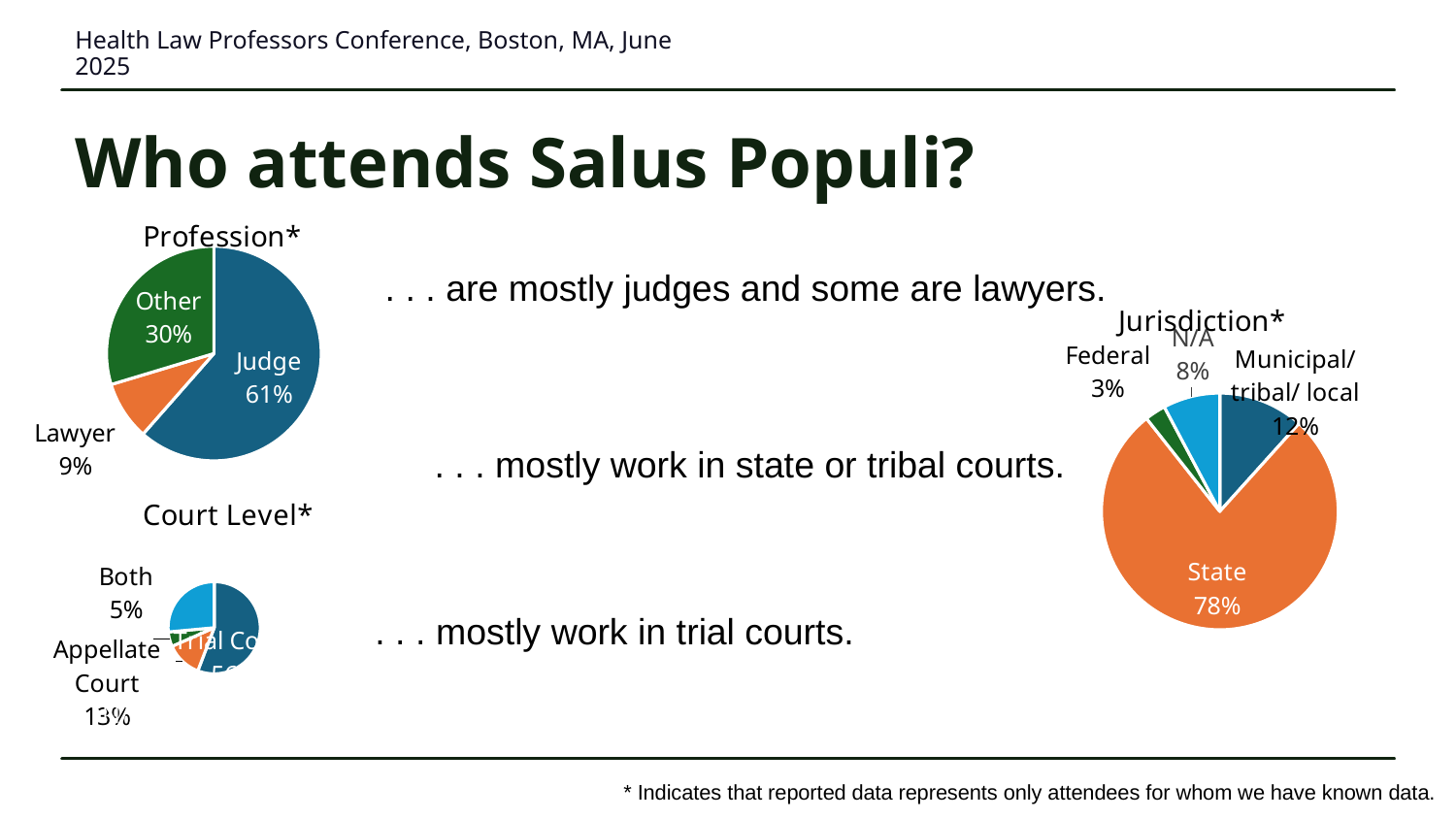
What kind of chart is the Jurisdiction* chart? Pie chart In the Profession* chart, which category has the largest share? Judge In the Profession* chart, what percentage of attendees are lawyers? 9% How many categories does the Profession* chart show? 3 In the Jurisdiction* chart, which is larger, Municipal/tribal/local or N/A? Municipal/tribal/local How many categories does the Jurisdiction* chart show? 4 In the Jurisdiction* chart, what percentage is Federal? 3% In the Profession* chart, what is the difference in percentage points between Judge and Other? 31 In the Profession* chart, what percentage of attendees are judges? 61% In the Profession* chart, which category has the smallest share? Lawyer In the Court Level* chart, what percentage of attendees work in both court levels? 5% In the Jurisdiction* chart, what percentage of attendees work in state courts? 78%